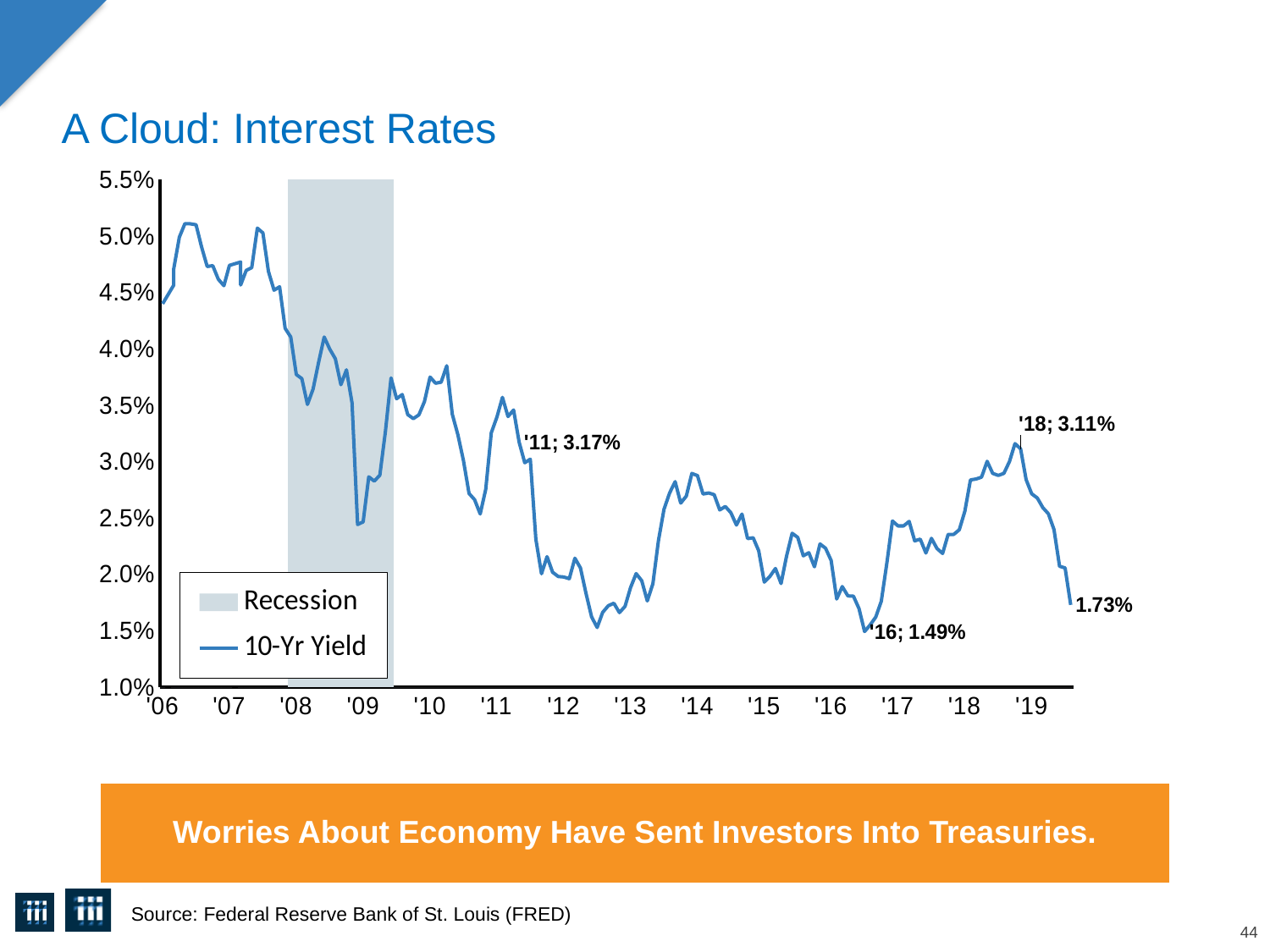
What does the grey shaded area on the chart represent? Recession What is the labeled 10-Yr Yield value at '11? 3.17% What is the difference between the labeled '11 value and the labeled '16 value? 1.68 percentage points Which labeled value is larger, the one at '11 or the one at '18? '11 (3.17%) What kind of chart is shown on the slide? line chart Overall, does the 10-Yr Yield rise or fall from '06 to '19? fall Is the lowest point of the 10-Yr Yield during '12 greater or less than 2.0%? less How many entries does the legend list? 2 Is the 10-Yr Yield at the start of '06 greater or less than 4.0%? greater What is the labeled 10-Yr Yield value at '16? 1.49% What is the labeled 10-Yr Yield value at '18? 3.11% What is the final labeled value of the 10-Yr Yield at the right end of the line? 1.73%